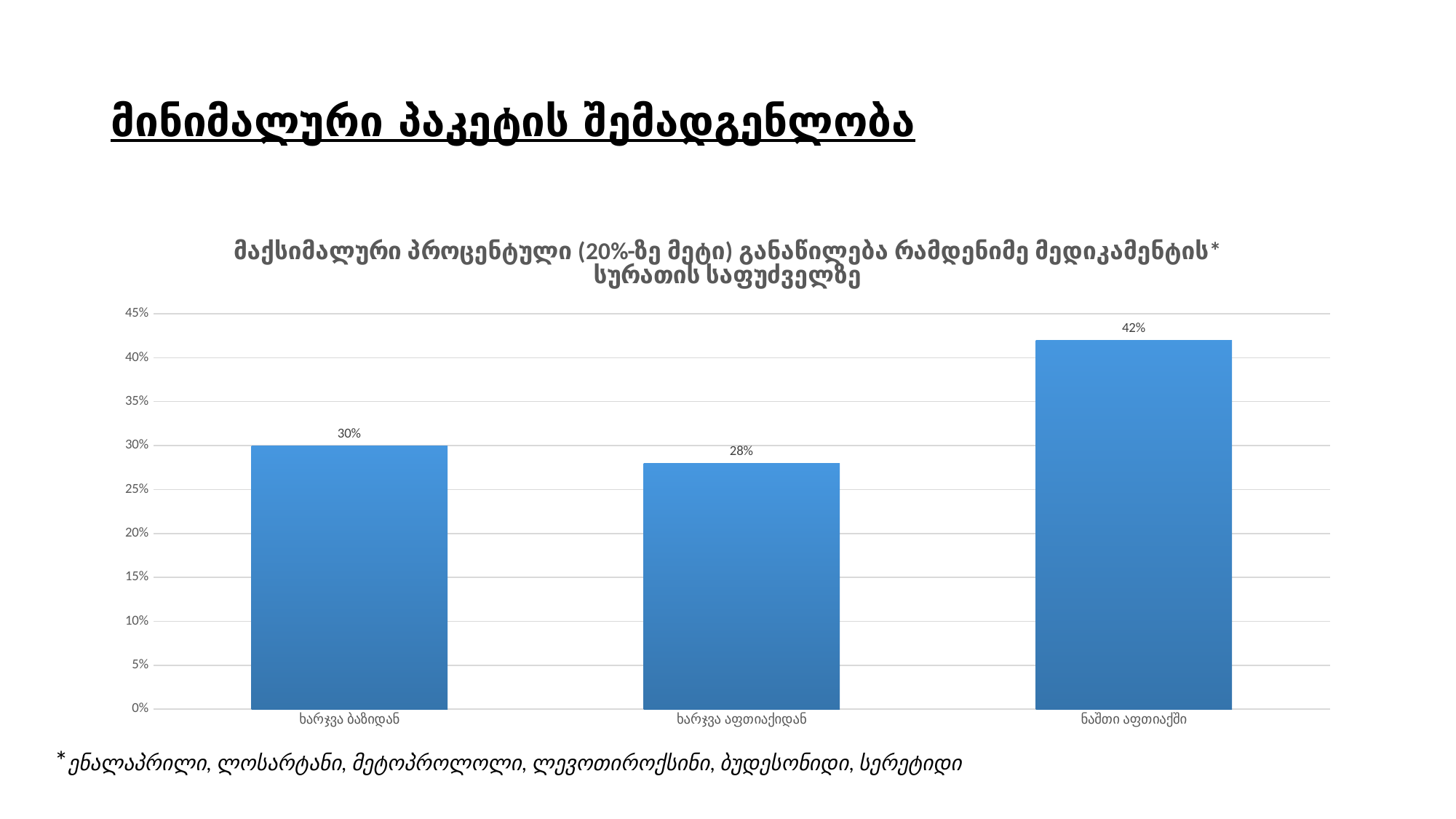
Is the value for ნაშთი აფთიაქში greater or less than 40%? greater What is the difference between the values for ნაშთი აფთიაქში and ხარჯვა ბაზიდან? 12% What is the value for ნაშთი აფთიაქში? 42% What is the value for ხარჯვა აფთიაქიდან? 28% Which is larger, the value for ნაშთი აფთიაქში or the value for ხარჯვა აფთიაქიდან? ნაშთი აფთიაქში What is the highest value shown on the vertical axis? 45% How many categories are shown in the chart? 3 Which category has the lowest value? ხარჯვა აფთიაქიდან Which category has the highest value? ნაშთი აფთიაქში What kind of chart is shown on the slide? bar chart What is the difference between the values for ხარჯვა ბაზიდან and ხარჯვა აფთიაქიდან? 2% What is the value for ხარჯვა ბაზიდან? 30%